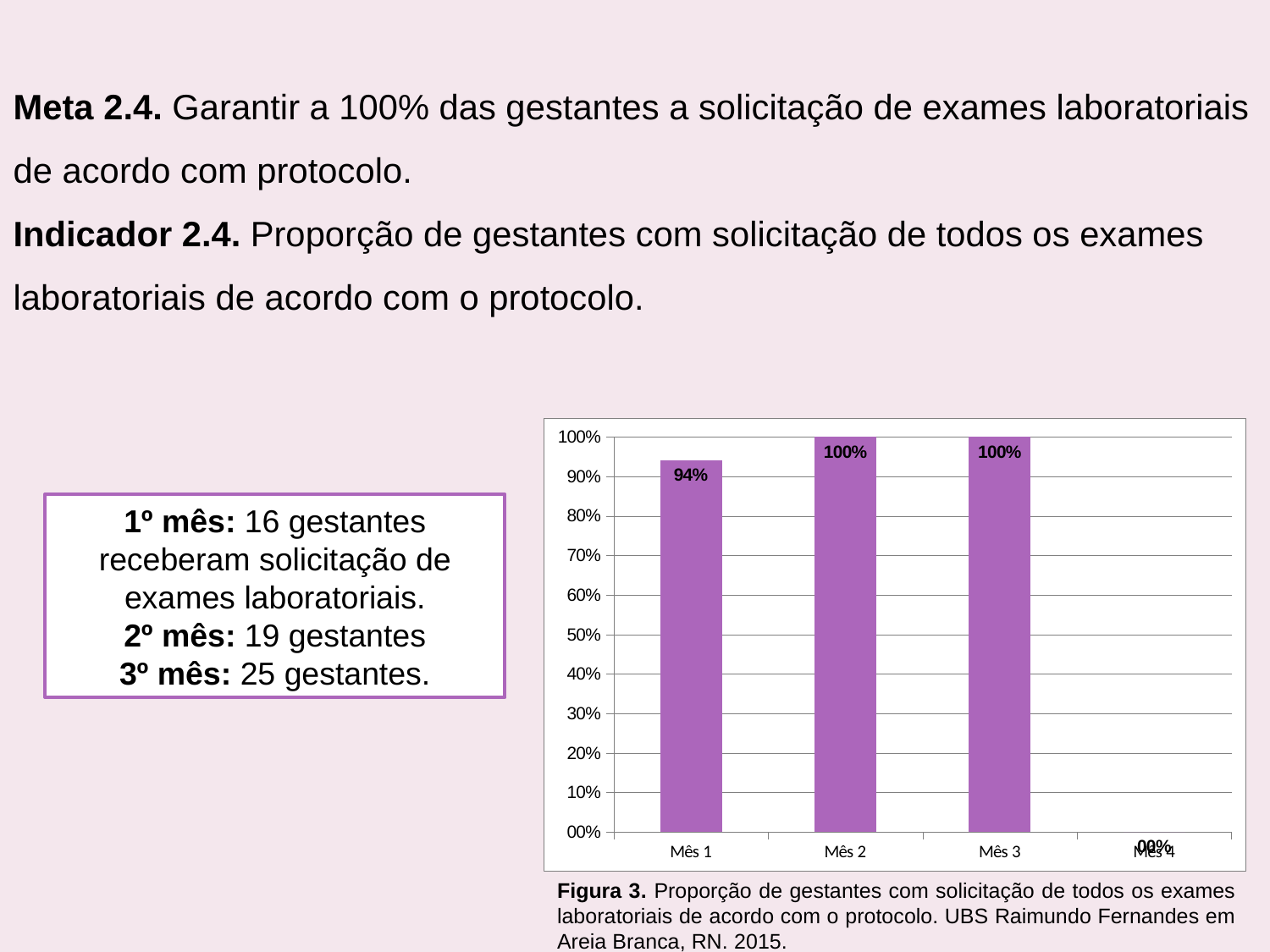
What is the value for Mês 2? 100% What kind of chart is shown? bar chart Is the value for Mês 1 greater or less than 90%? greater Among Mês 1, Mês 2 and Mês 3, which has the lowest value? Mês 1 Which is larger, the value for Mês 1 or the value for Mês 3? Mês 3 Which months reach 100%? Mês 2 and Mês 3 What colour are the bars in the chart? purple What is the value for Mês 3? 100% What is the difference between the values for Mês 2 and Mês 1? 6% Do the values rise or fall from Mês 1 to Mês 2? rise What is the value for Mês 1? 94% How many month categories are shown on the x axis? 4